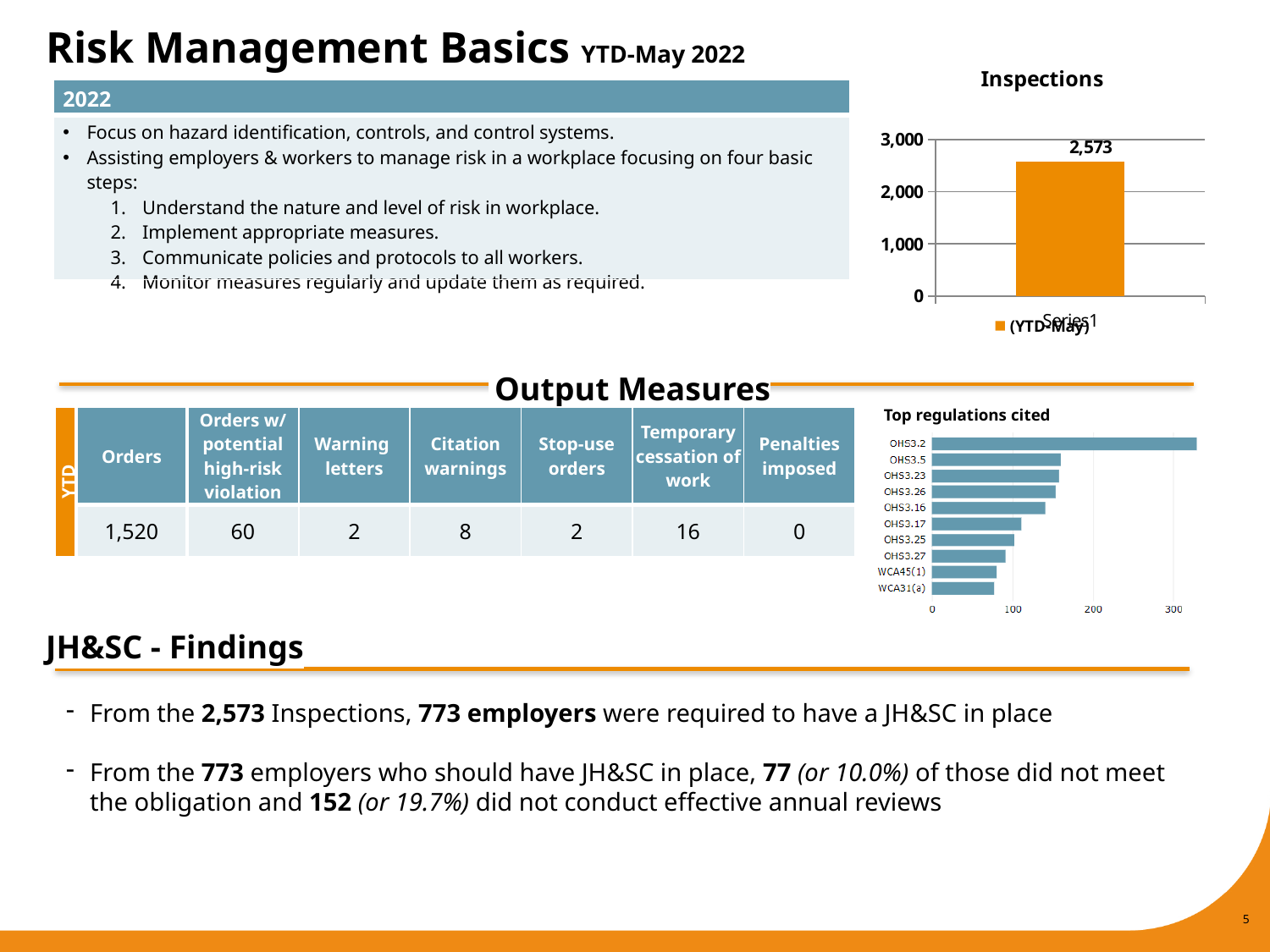
On the Top regulations cited chart, is the value for OHS3.2 greater or less than 300? greater On the Top regulations cited chart, which has the larger value, OHS3.16 or WCA45(1)? OHS3.16 On the Inspections chart, what is the value shown for the bar? 2,573 What is the title of the chart in the top right of the slide? Inspections What kind of chart is the Top regulations cited chart? bar chart What kind of chart is the Inspections chart? bar chart On the Top regulations cited chart, is the value for OHS3.5 greater or less than 100? greater How many regulations are listed on the Top regulations cited chart? 10 On the Inspections chart, is the value for the bar greater or less than 2,000? greater On the Top regulations cited chart, which regulation has the highest value? OHS3.2 How many bars are plotted on the Inspections chart? 1